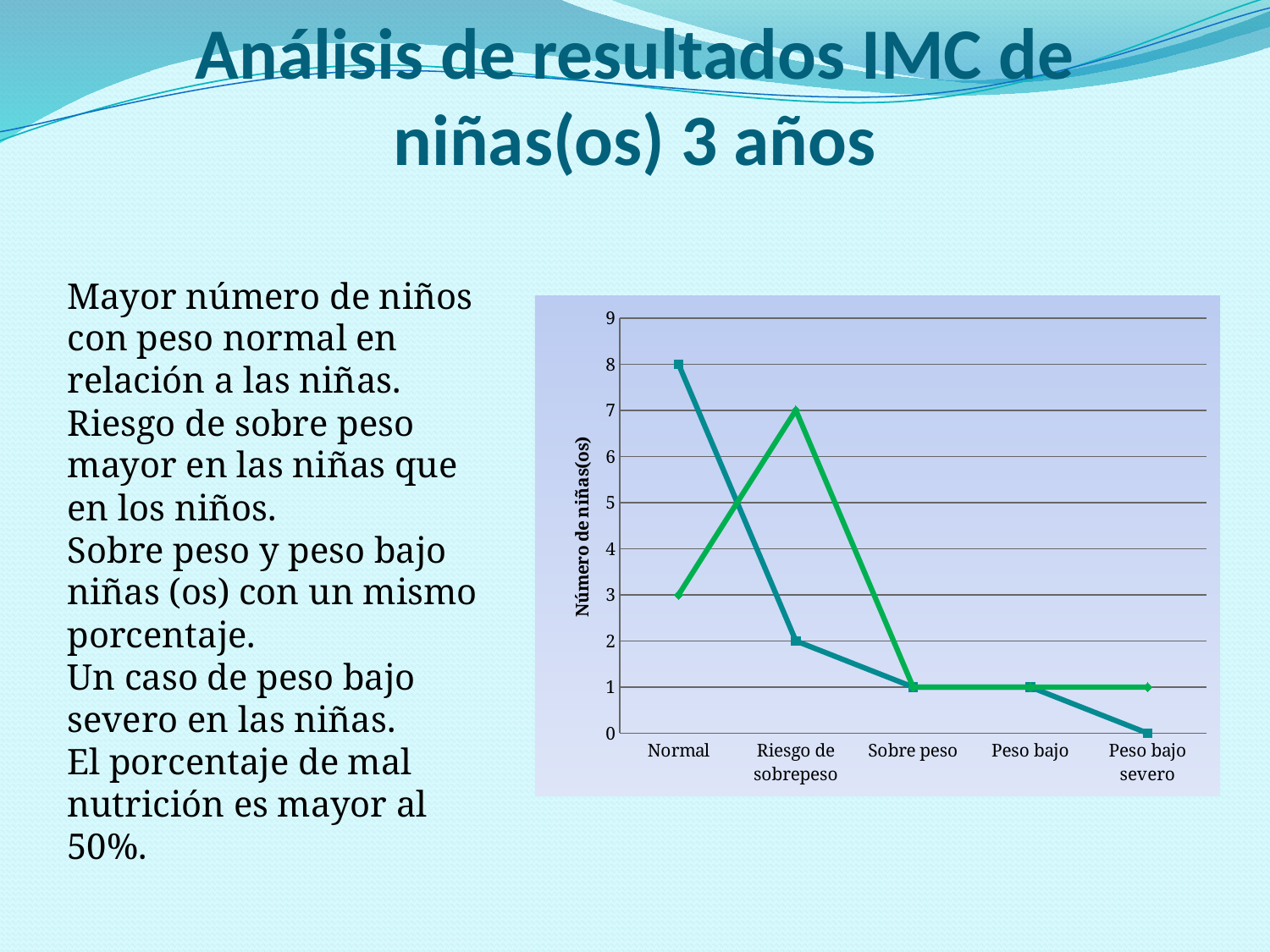
What is the title of the vertical axis of the chart? Número de niñas(os) What is the value of the green line for the category Riesgo de sobrepeso? 7 For which category does the green line reach its highest value? Riesgo de sobrepeso For which category does the teal line reach its highest value? Normal What is the difference between the teal line and the green line for the category Normal? 5 How many categories are shown on the x axis of the chart? 5 For the category Riesgo de sobrepeso, which line has the larger value, the teal line or the green line? green line What kind of chart is shown on the slide? line chart What is the value of the green line for the category Normal? 3 How many lines (series) are plotted on the chart? 2 What is the value of the teal line for the category Normal? 8 What is the value of the teal line for the category Peso bajo severo? 0